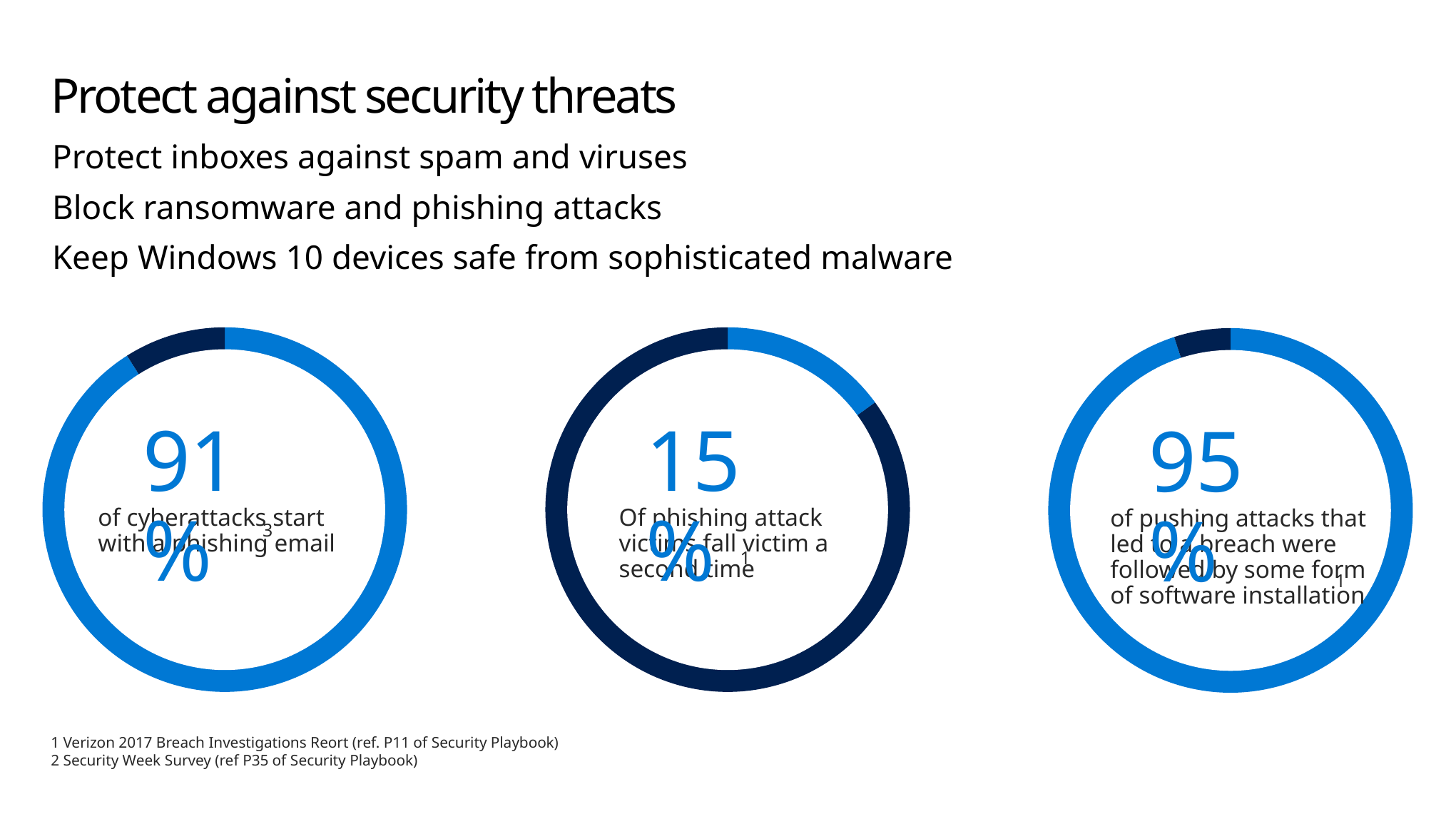
What kind of chart is used for the three figures on the slide? doughnut chart In the middle chart, which colour represents the 15% segment? light blue Is the value in the left chart or the value in the middle chart larger? the left chart (91%) What is the difference in percentage points between the left chart's value and the middle chart's value? 76 How many doughnut charts are shown on the slide? 3 In the left chart, what percentage of cyberattacks start with a phishing email? 91% Which of the three doughnut charts shows the lowest percentage? the middle chart (15%) In the left chart, what share of the ring is filled by the light blue segment? 91% In the right chart, what percentage of phishing attacks that led to a breach were followed by some form of software installation? 95% What is the difference in percentage points between the right chart's value and the left chart's value? 4 In the middle chart, what percentage of phishing attack victims fall victim a second time? 15% Which of the three doughnut charts shows the highest percentage? the right chart (95%)